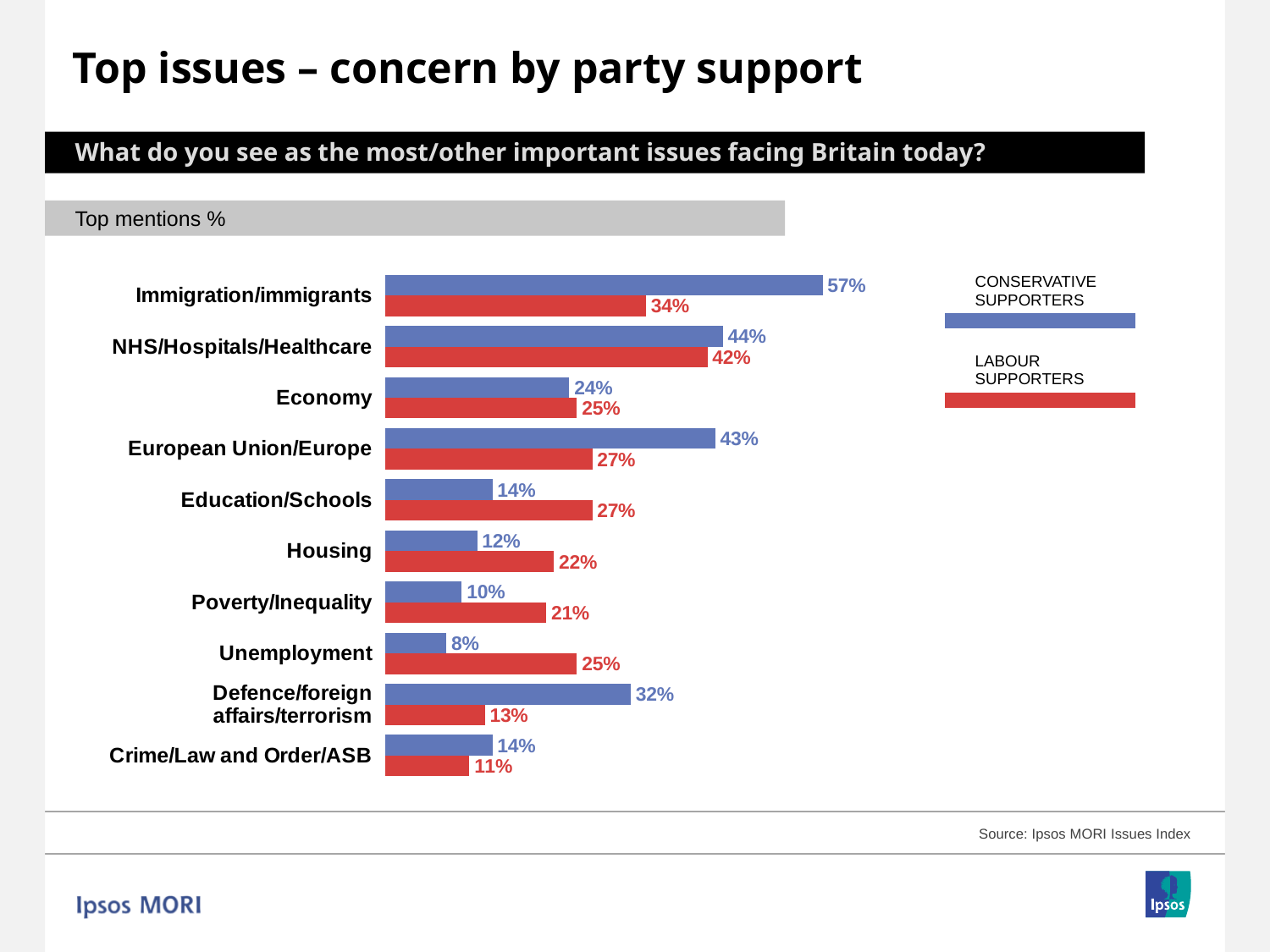
What percentage of Labour supporters mention Unemployment? 25% What percentage of Conservative supporters mention Immigration/immigrants? 57% What percentage of Labour supporters mention Education/Schools? 27% How many issues are listed on the chart? 10 How many series does the legend list? 2 Which issue has the highest value among Conservative supporters? Immigration/immigrants What colour represents Labour supporters in the chart? Red What is the difference between Conservative and Labour supporters for European Union/Europe? 16 percentage points For Housing, which group has the larger value, Conservative supporters or Labour supporters? Labour supporters Which issue has the lowest value among Conservative supporters? Unemployment Which issue has the highest value among Labour supporters? NHS/Hospitals/Healthcare What kind of chart is shown on the slide? Bar chart